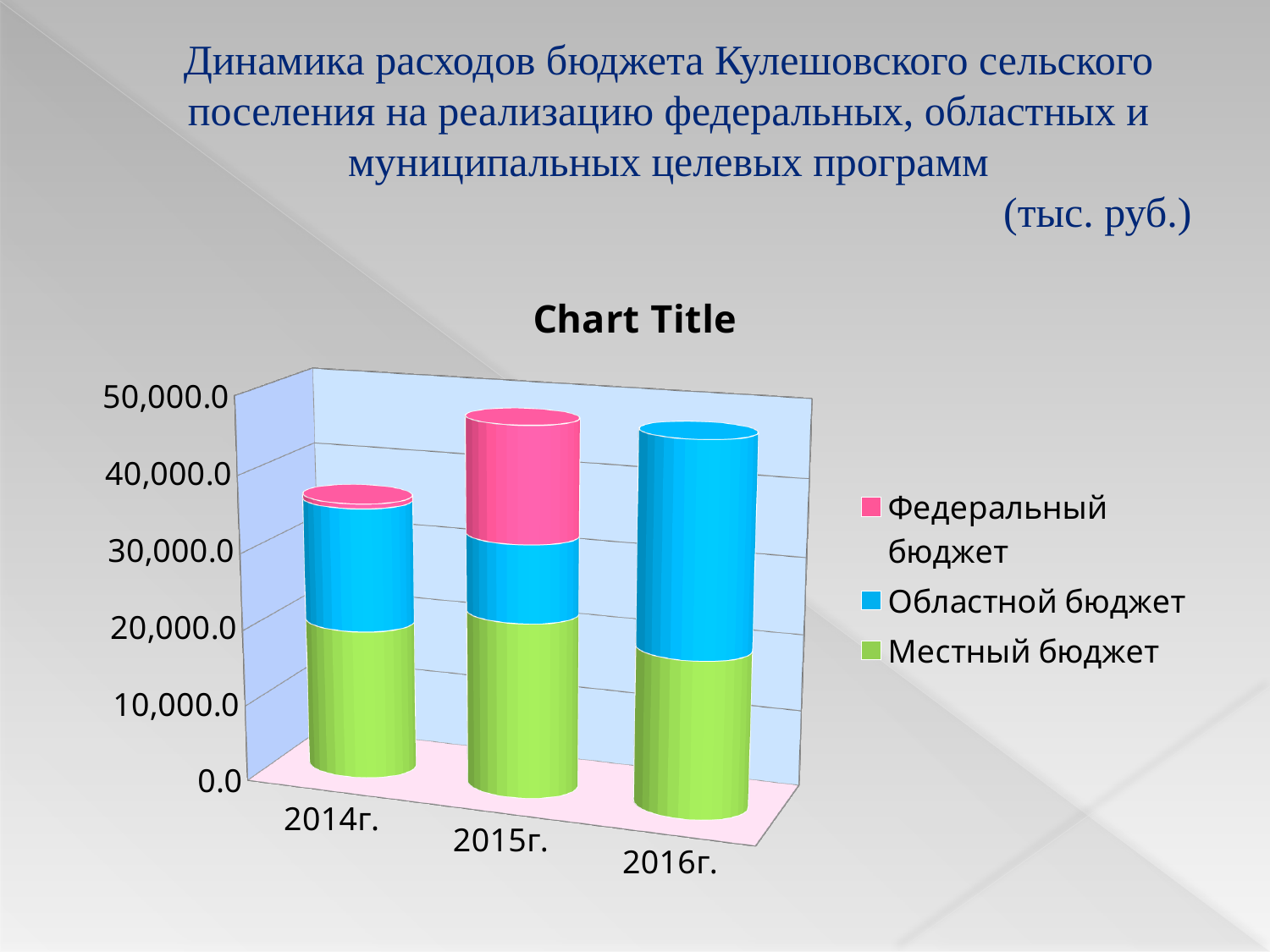
What kind of chart is shown on the slide? bar chart Which colour represents Местный бюджет in the chart legend? green Is the total value of the stacked bar for 2014г. greater or less than 30,000.0? greater Is the total value of the stacked bar for 2015г. greater or less than 40,000.0? greater How many years (categories) are shown on the x axis of the chart? 3 Is the Областной бюджет segment larger in 2016г. or in 2014г.? 2016г. How many series does the chart legend list? 3 Which year has the largest Федеральный бюджет segment? 2015г. Which year has the lowest total stacked bar? 2014г. Which year has the largest Областной бюджет segment? 2016г. What title is printed above the chart? Chart Title Is the Федеральный бюджет segment larger in 2015г. or in 2014г.? 2015г.